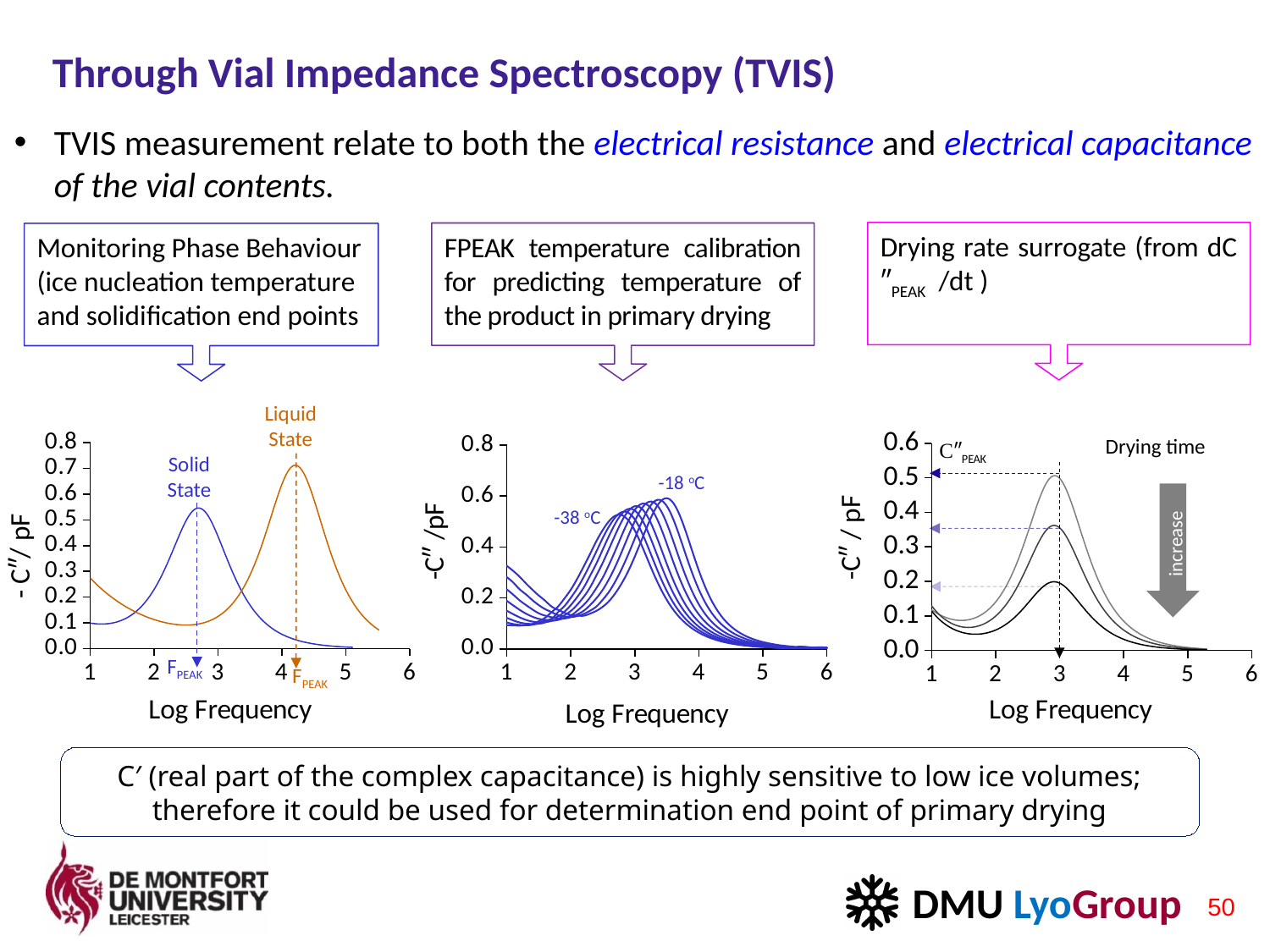
In the middle chart, is the peak value of the -18 °C curve greater or less than 0.4? greater In the left chart, which curve peaks at the higher log frequency, Solid State or Liquid State? Liquid State In the right chart, does the peak height rise or fall as drying time increases? fall In the middle chart, what two temperatures are labelled on the curves? -38 °C and -18 °C What type of chart is the left chart showing Solid State and Liquid State? line chart In the left chart, is the peak value of the Solid State curve greater or less than 0.7? less In the middle chart, is the peak value of the -18 °C curve greater or less than 0.8? less What is the x-axis label of the left chart? Log Frequency How many curves are plotted in the right chart (Drying time)? 3 In the left chart, which curve reaches the higher peak, Solid State or Liquid State? Liquid State